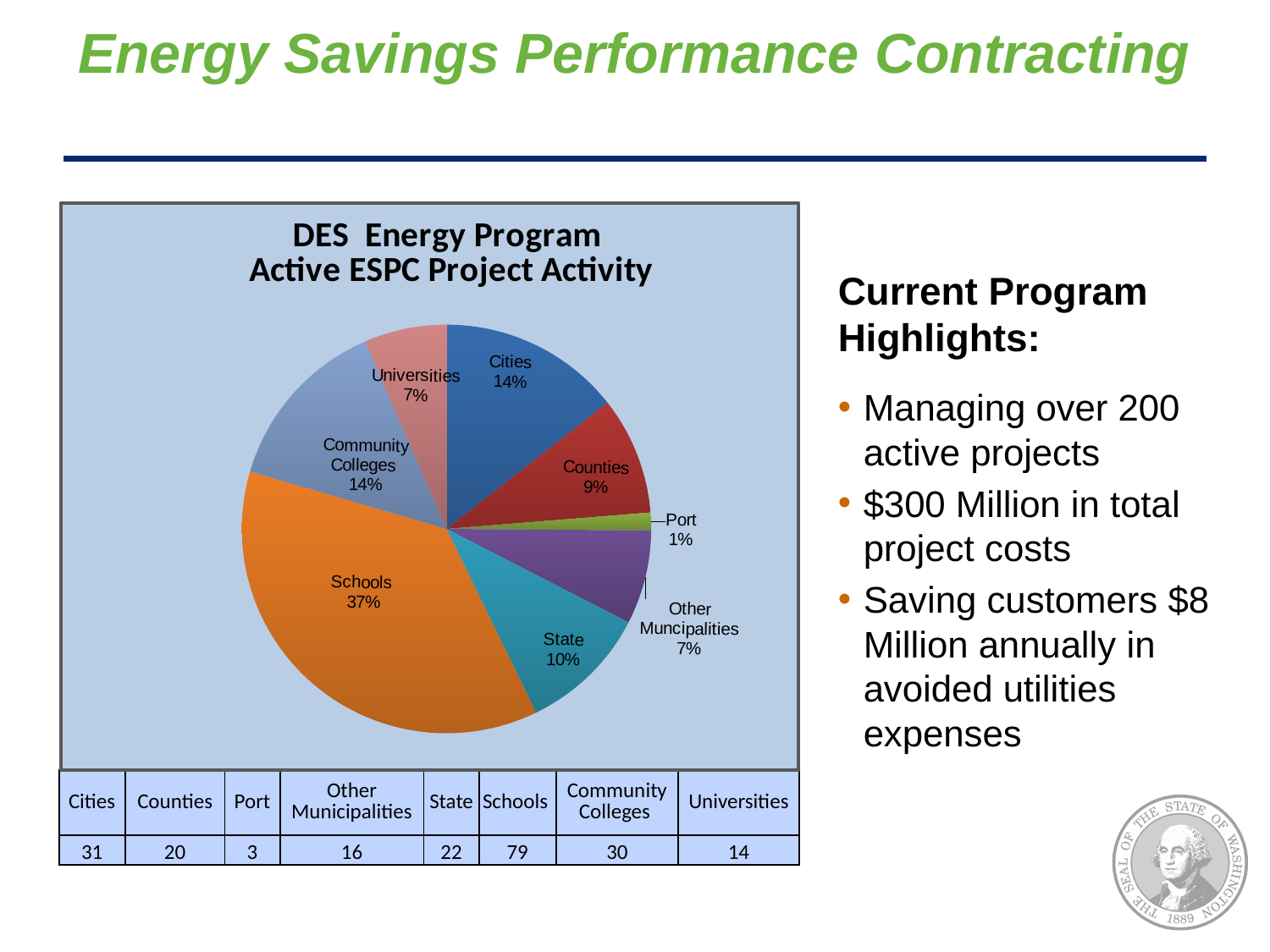
What percentage share does Port have in the pie chart? 1% What kind of chart is shown on the slide? pie chart How many categories does the pie chart show? 8 Which has more projects in the data table, Cities or Counties? Cities What percentage of active ESPC project activity is attributed to Schools? 37% Which category has the smallest share of active ESPC projects? Port What is the title of the pie chart? DES Energy Program Active ESPC Project Activity What is the total number of projects across all categories in the data table? 215 What is the difference between the number of Schools projects and Community Colleges projects in the data table? 49 According to the data table, how many active projects are there for State? 22 According to the data table, how many active projects are there for Universities? 14 Which category has the largest share of active ESPC projects? Schools